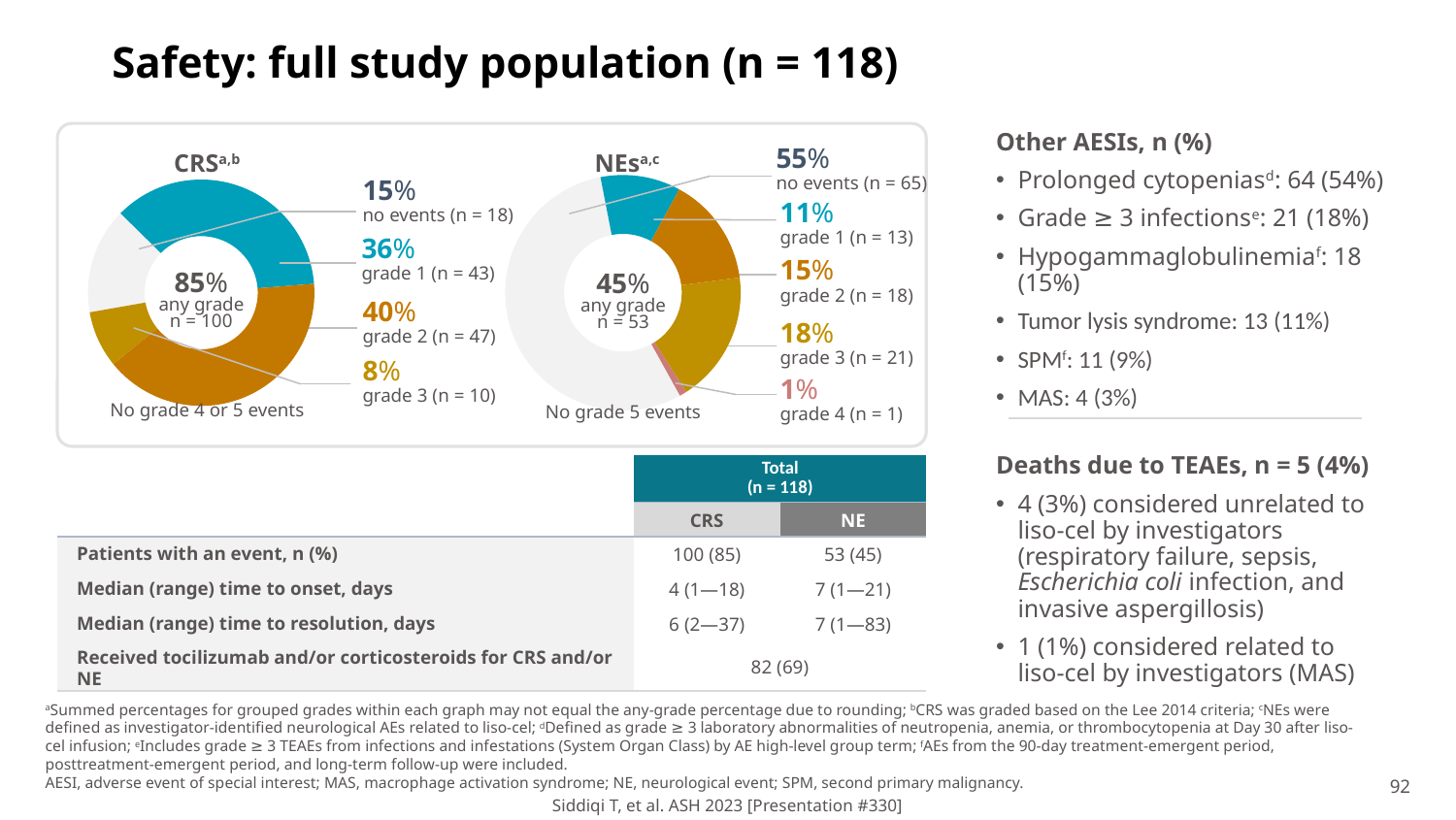
In the NEs chart, how many patients had grade 3 NEs? 21 In the NEs chart, what percentage of patients had no events? 55% In the CRS chart, which grade category has the largest share? grade 2 In the NEs chart, how many grade categories (excluding no events) are shown? 4 What note appears below the NEs chart about grade 5 events? No grade 5 events In the CRS chart, what percentage of patients had grade 2 CRS? 40% In the CRS chart, how many patients had grade 1 CRS? 43 In the NEs chart, which category has the smallest share? grade 4 Which is larger: the percentage of patients with any-grade CRS or the percentage with any-grade NEs? any-grade CRS In the CRS chart, what is the difference in percentage points between grade 2 and grade 3 CRS? 32 In the CRS chart, what is the any-grade percentage shown in the centre of the donut? 85% What type of chart is used to show the CRS and NE grade distributions? Donut (pie) chart